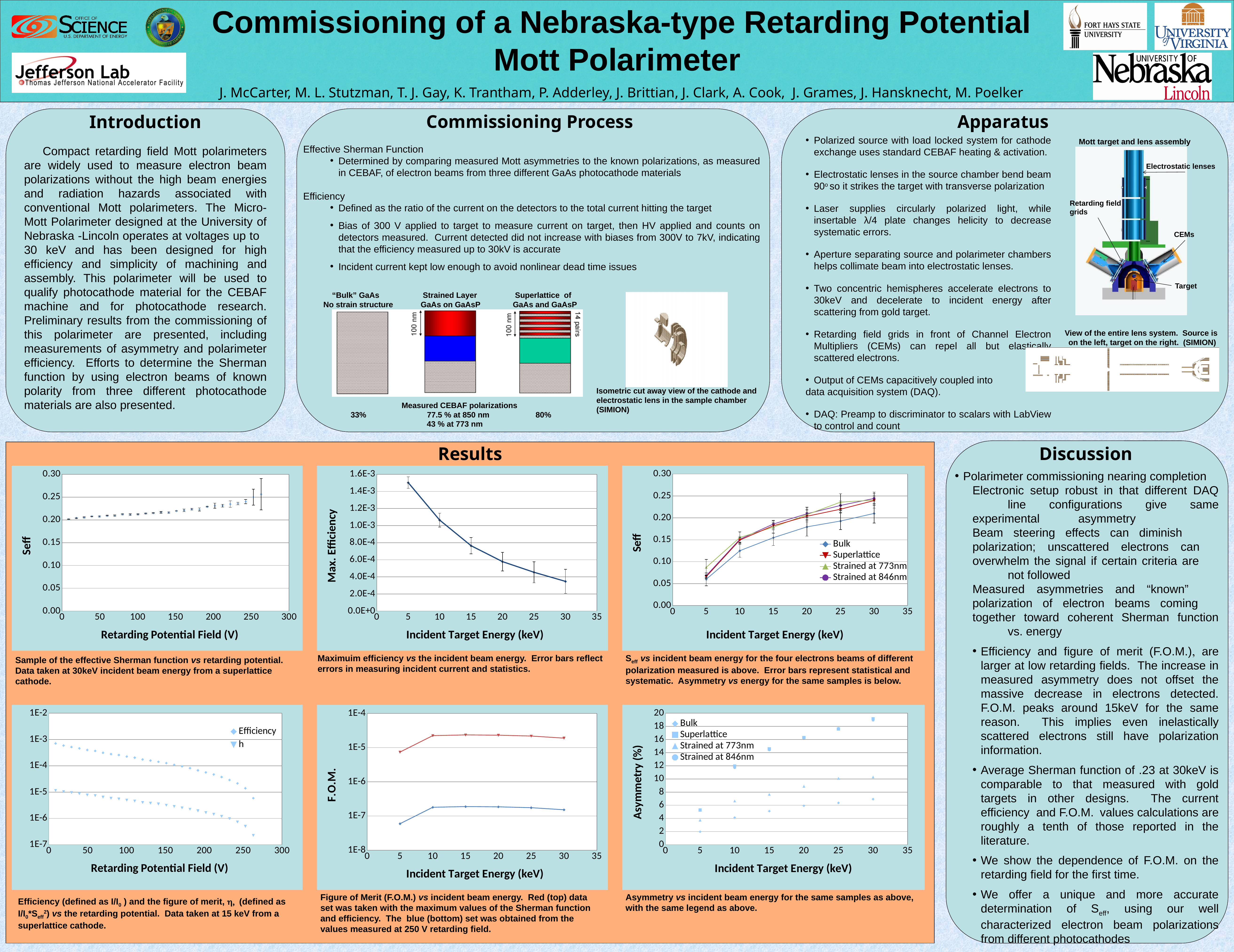
In the Asymmetry (%) vs Incident Target Energy (keV) chart (bottom right of the Results section), is the Bulk value at 5 keV greater or less than 4? less In the Max. Efficiency vs Incident Target Energy (keV) chart (top middle of the Results section), is the value at 30 keV greater or less than 6.0E-4? less In the F.O.M. vs Incident Target Energy (keV) chart (bottom middle of the Results section), which data set has the larger values, the red or the blue? red In the Seff vs Retarding Potential Field (V) chart (top left of the Results section), is the value at 0 V greater or less than 0.15? greater In the Asymmetry (%) vs Incident Target Energy (keV) chart (bottom right of the Results section), which series has the lowest asymmetry at 30 keV? Bulk In the Seff vs Retarding Potential Field (V) chart (top left of the Results section), do the values rise or fall as the retarding potential increases? rise In the Max. Efficiency vs Incident Target Energy (keV) chart (top middle of the Results section), how many data points are plotted? 6 In the chart of Seff vs Incident Target Energy (keV) (top right of the Results section), what are the legend entries? Bulk, Superlattice, Strained at 773nm, Strained at 846nm In the Max. Efficiency vs Incident Target Energy (keV) chart (top middle of the Results section), do the values rise or fall as the incident target energy increases? fall In the Efficiency and η vs Retarding Potential Field (V) chart (bottom left of the Results section), how many series does the legend list? 2 In the chart of Seff vs Incident Target Energy (keV) (top right of the Results section), how many series does the legend list? 4